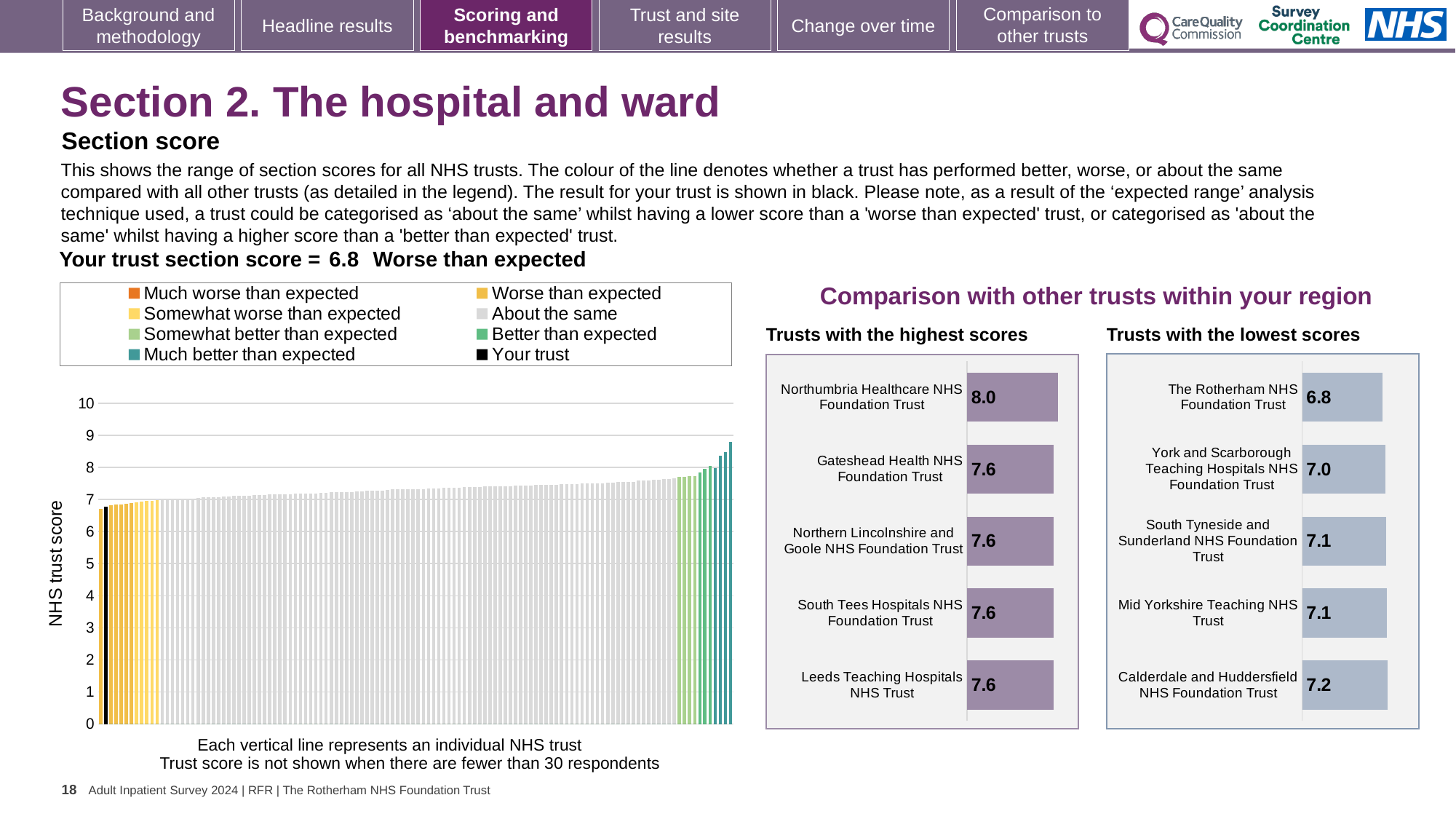
How many trusts are listed in the 'Trusts with the highest scores' chart? 5 In the 'Trusts with the highest scores' chart, what is the difference between the scores of Northumbria Healthcare NHS Foundation Trust and Gateshead Health NHS Foundation Trust? 0.4 In the large chart on the left, is the value of the tallest bar greater or less than 8? greater In the 'Trusts with the lowest scores' chart, which trust has the lowest score? The Rotherham NHS Foundation Trust In the 'Trusts with the lowest scores' chart, what is the score for Calderdale and Huddersfield NHS Foundation Trust? 7.2 How many entries does the legend above the large chart on the left list? 8 In the 'Trusts with the lowest scores' chart, what is the difference between the scores of Calderdale and Huddersfield NHS Foundation Trust and The Rotherham NHS Foundation Trust? 0.4 In the 'Trusts with the lowest scores' chart, which has the higher score: York and Scarborough Teaching Hospitals NHS Foundation Trust or South Tyneside and Sunderland NHS Foundation Trust? South Tyneside and Sunderland NHS Foundation Trust In the large chart on the left, do the NHS trust scores rise or fall from left to right? Rise What kind of chart is the large chart on the left showing NHS trust scores? Bar chart In the 'Trusts with the highest scores' chart, what is the score for Northumbria Healthcare NHS Foundation Trust? 8.0 In the 'Trusts with the highest scores' chart, which trust has the highest score? Northumbria Healthcare NHS Foundation Trust